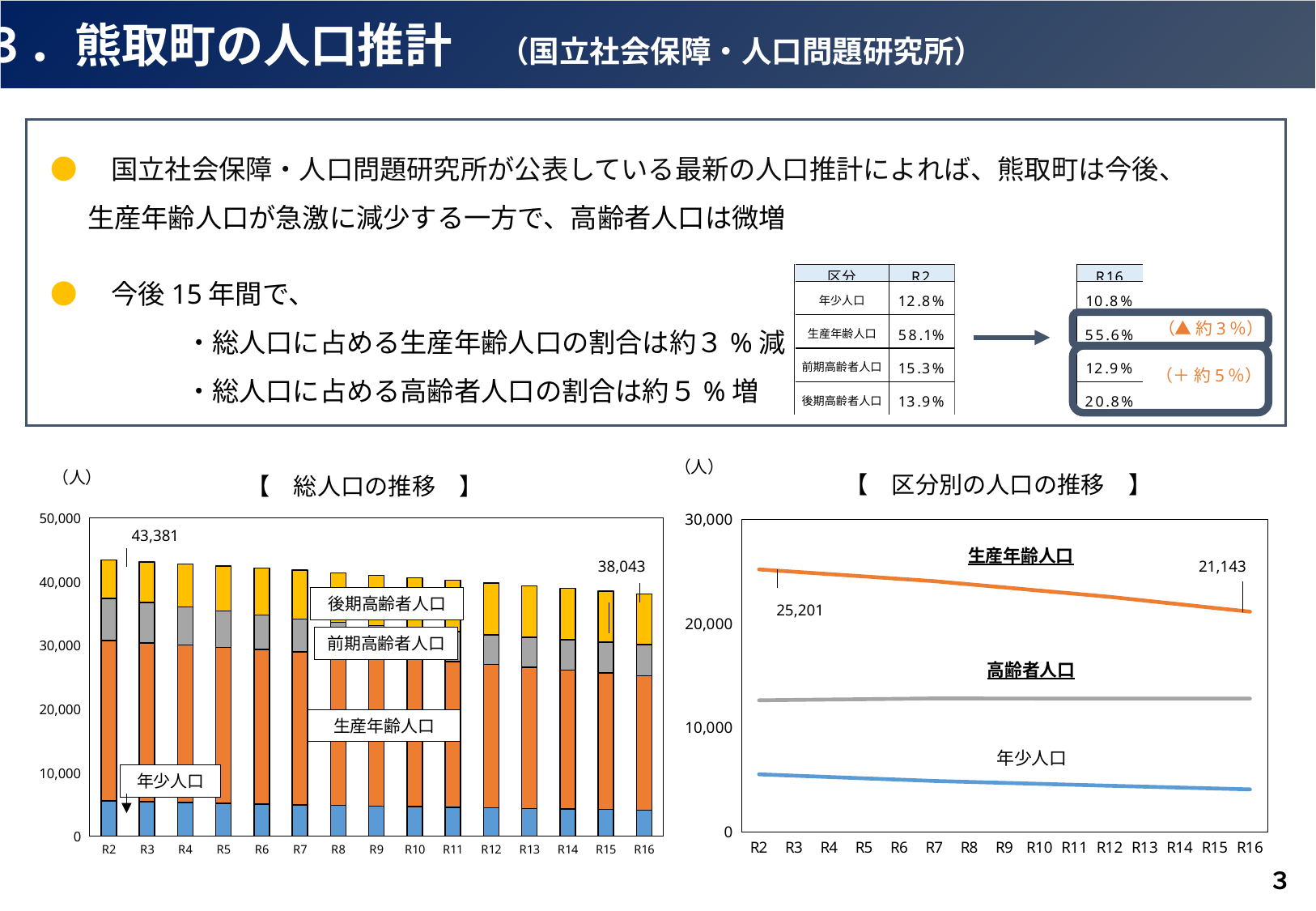
In the 【区分別の人口の推移】 chart, by how much does 生産年齢人口 decrease from R2 to R16? 4,058 What kind of chart is the 【総人口の推移】 chart on the left? stacked bar chart In the 【総人口の推移】 chart, is the total for R16 greater or less than 40,000? less What kind of chart is the 【区分別の人口の推移】 chart on the right? line chart In the 【総人口の推移】 chart, by how much does the total population fall from R2 to R16? 5,338 In the 【区分別の人口の推移】 chart, is the value of 年少人口 in R2 greater or less than 10,000? less In the 【総人口の推移】 chart, how many years are shown on the x axis? 15 In the 【区分別の人口の推移】 chart, what is the value of 生産年齢人口 in R16? 21,143 In the 【総人口の推移】 chart, what is the total population shown for R16? 38,043 In the 【総人口の推移】 chart, what is the total population shown for R2? 43,381 In the 【総人口の推移】 chart, does the total population rise or fall from R2 to R16? fall In the 【区分別の人口の推移】 chart, what is the value of 生産年齢人口 in R2? 25,201